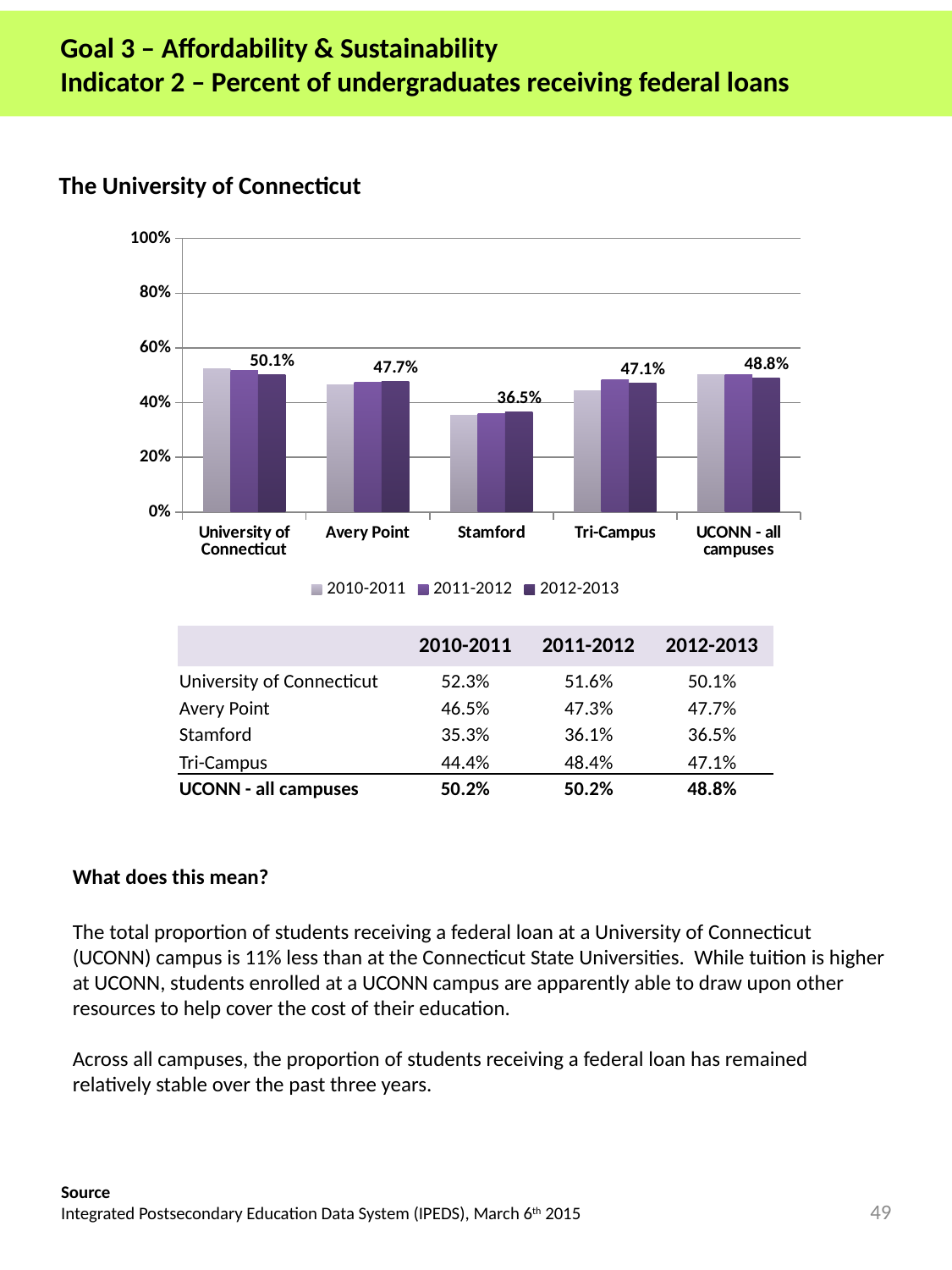
What is the 2012-2013 value for UCONN - all campuses? 48.8% Do the values for University of Connecticut rise or fall from 2010-2011 to 2012-2013? fall What is the 2012-2013 value for Stamford? 36.5% How many series does the chart legend list? 3 How many campus categories are shown on the x axis of the chart? 5 Which campus has the lowest value for 2012-2013? Stamford What type of chart is shown on the slide? bar chart Is the 2012-2013 value for Tri-Campus greater or less than 40%? greater What is the difference between the 2012-2013 values for University of Connecticut and Stamford? 13.6% Which is larger for 2012-2013: Avery Point or Tri-Campus? Avery Point Which campus has the highest value for 2012-2013? University of Connecticut What is the 2012-2013 value for Avery Point? 47.7%